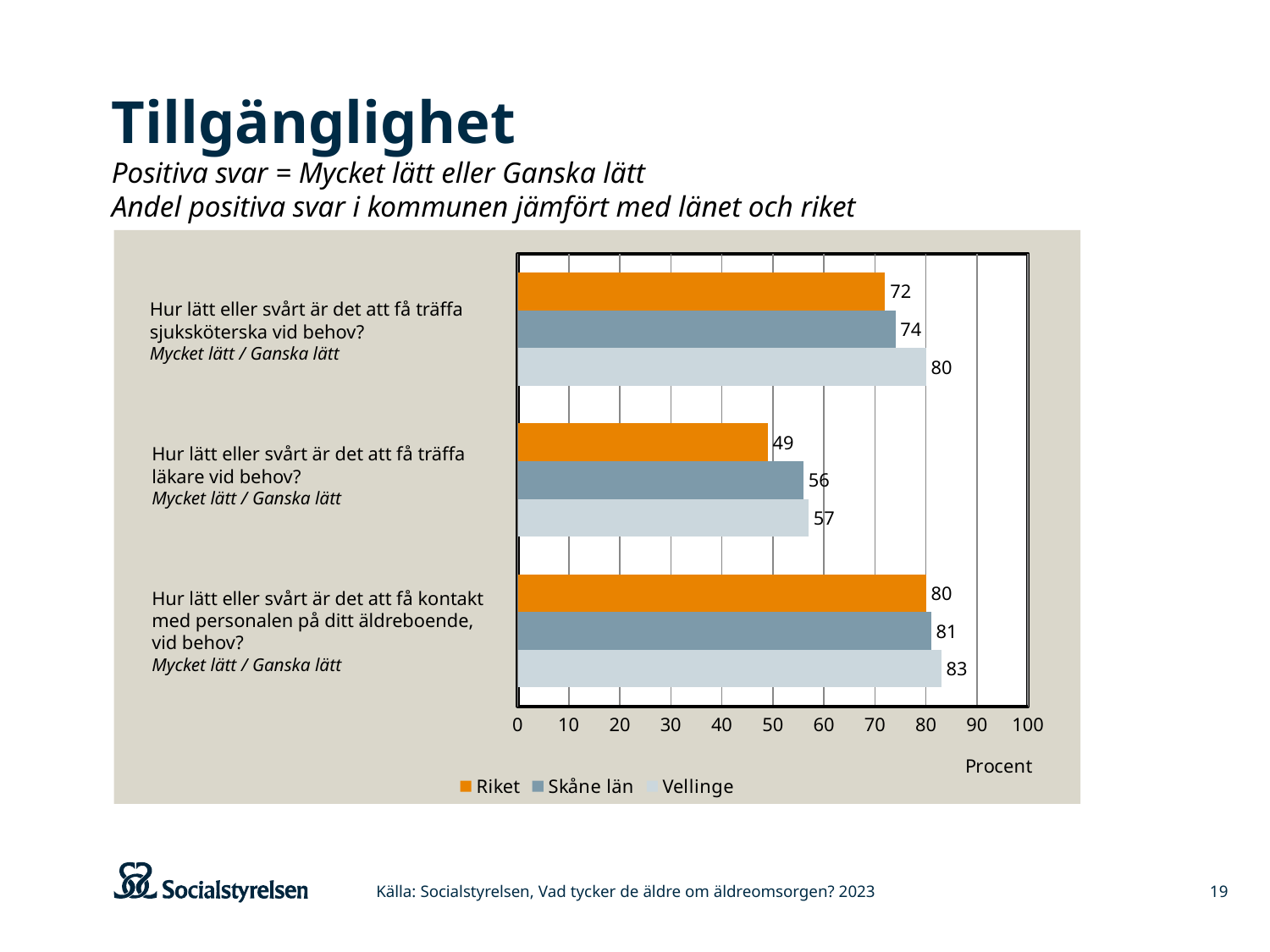
Is the Riket value on the question about meeting a doctor when needed greater or less than 50? less How many questions (categories) are shown in the chart? 3 What unit label is shown on the horizontal axis of the chart? Procent What value is shown for Vellinge on the question about meeting a nurse when needed ("Hur lätt eller svårt är det att få träffa sjuksköterska vid behov?")? 80 What kind of chart is shown on the slide? bar chart On the question about meeting a doctor when needed, which is larger: the value for Skåne län or the value for Riket? Skåne län What value is shown for Riket on the question about meeting a doctor when needed ("Hur lätt eller svårt är det att få träffa läkare vid behov?")? 49 What is the difference between the Vellinge value and the Riket value on the question about meeting a nurse when needed? 8 Which question has the lowest value for Riket? Hur lätt eller svårt är det att få träffa läkare vid behov? How many series does the legend list? 3 What value is shown for Skåne län on the question about getting in contact with staff at the care home ("Hur lätt eller svårt är det att få kontakt med personalen på ditt äldreboende, vid behov?")? 81 Which question has the highest value for Vellinge? Hur lätt eller svårt är det att få kontakt med personalen på ditt äldreboende, vid behov?